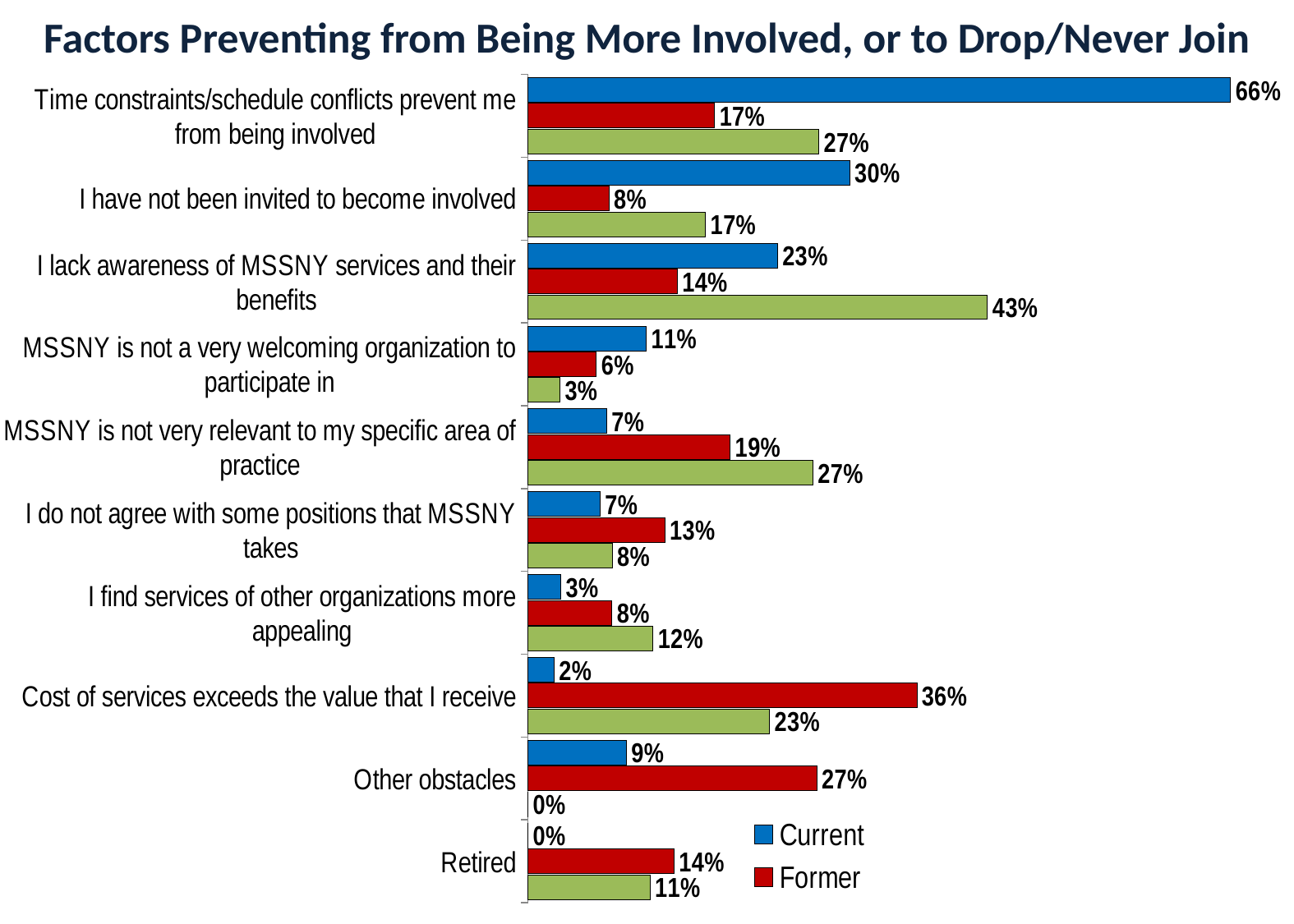
What colour represents the Former series in the legend? Red What is the difference between the Current and Former values for "Time constraints/schedule conflicts prevent me from being involved"? 49% How many series does the legend list? 2 What is the Current value for "Time constraints/schedule conflicts prevent me from being involved"? 66% What kind of chart is shown on the slide? Bar chart Which category has the lowest Current value? Retired What is the Former value for "I have not been invited to become involved"? 8% What is the Former value for "Cost of services exceeds the value that I receive"? 36% Which category has the highest Former value? Cost of services exceeds the value that I receive Which category has the highest Current value? Time constraints/schedule conflicts prevent me from being involved For "MSSNY is not very relevant to my specific area of practice", which is larger, the Current value or the Former value? Former How many categories are shown on the chart? 10